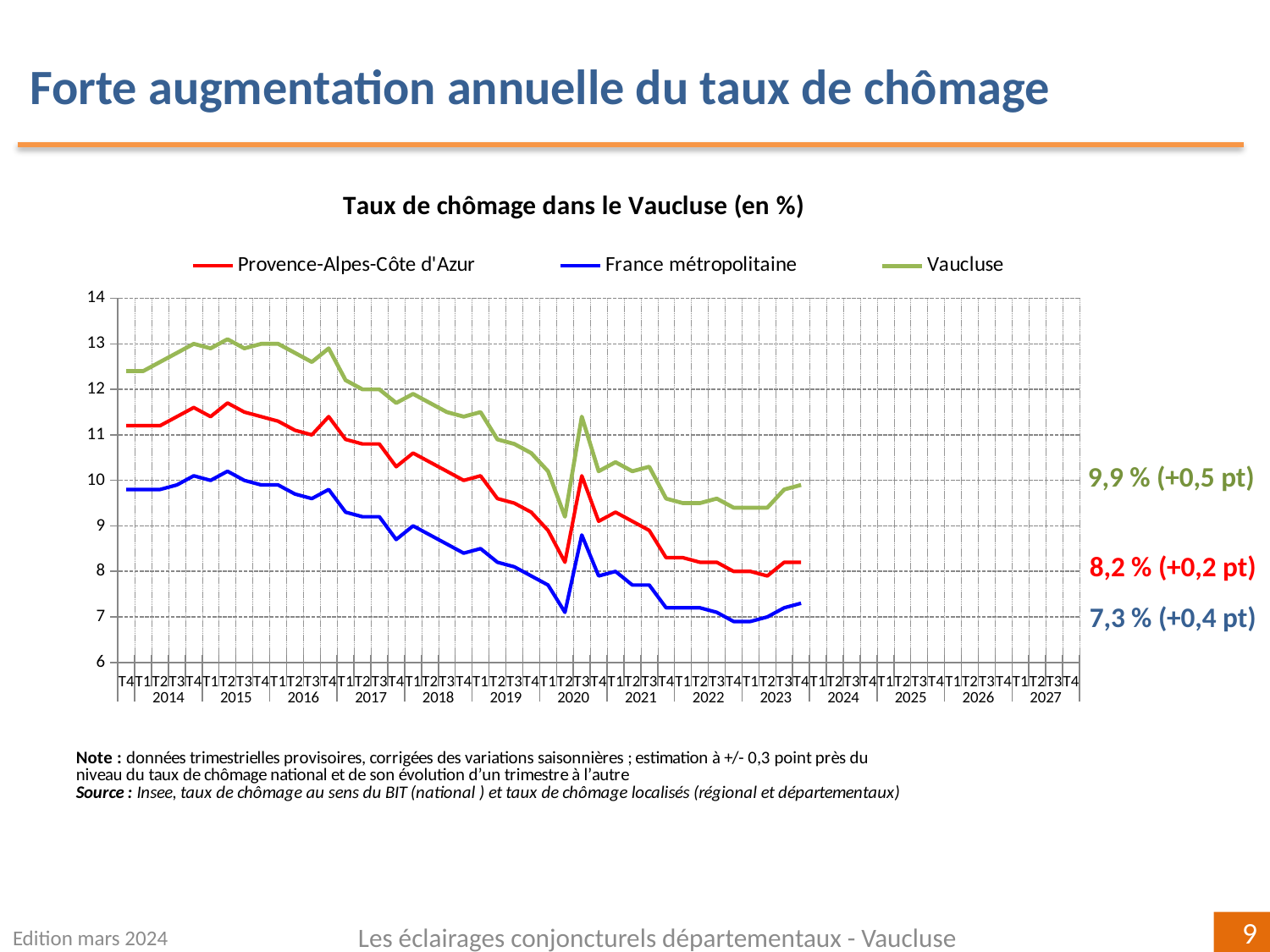
Which series has the highest value at the end of the plotted period? Vaucluse What kind of chart is shown on the slide? line chart What is the latest unemployment rate shown for France métropolitaine? 7,3 % Overall, do the Vaucluse values rise or fall from 2014 to 2023? fall How many series does the legend list? 3 What is the difference between the latest Vaucluse rate and the latest France métropolitaine rate? 2,6 points What is the title of the chart? Taux de chômage dans le Vaucluse (en %) Is the value for Vaucluse in 2015 greater or less than 12? greater What is the latest unemployment rate shown for Provence-Alpes-Côte d'Azur? 8,2 % What is the latest unemployment rate shown for Vaucluse? 9,9 % Which series has the lowest value at the end of the plotted period? France métropolitaine By how many points did the Vaucluse rate change according to the label at the end of its line? +0,5 pt